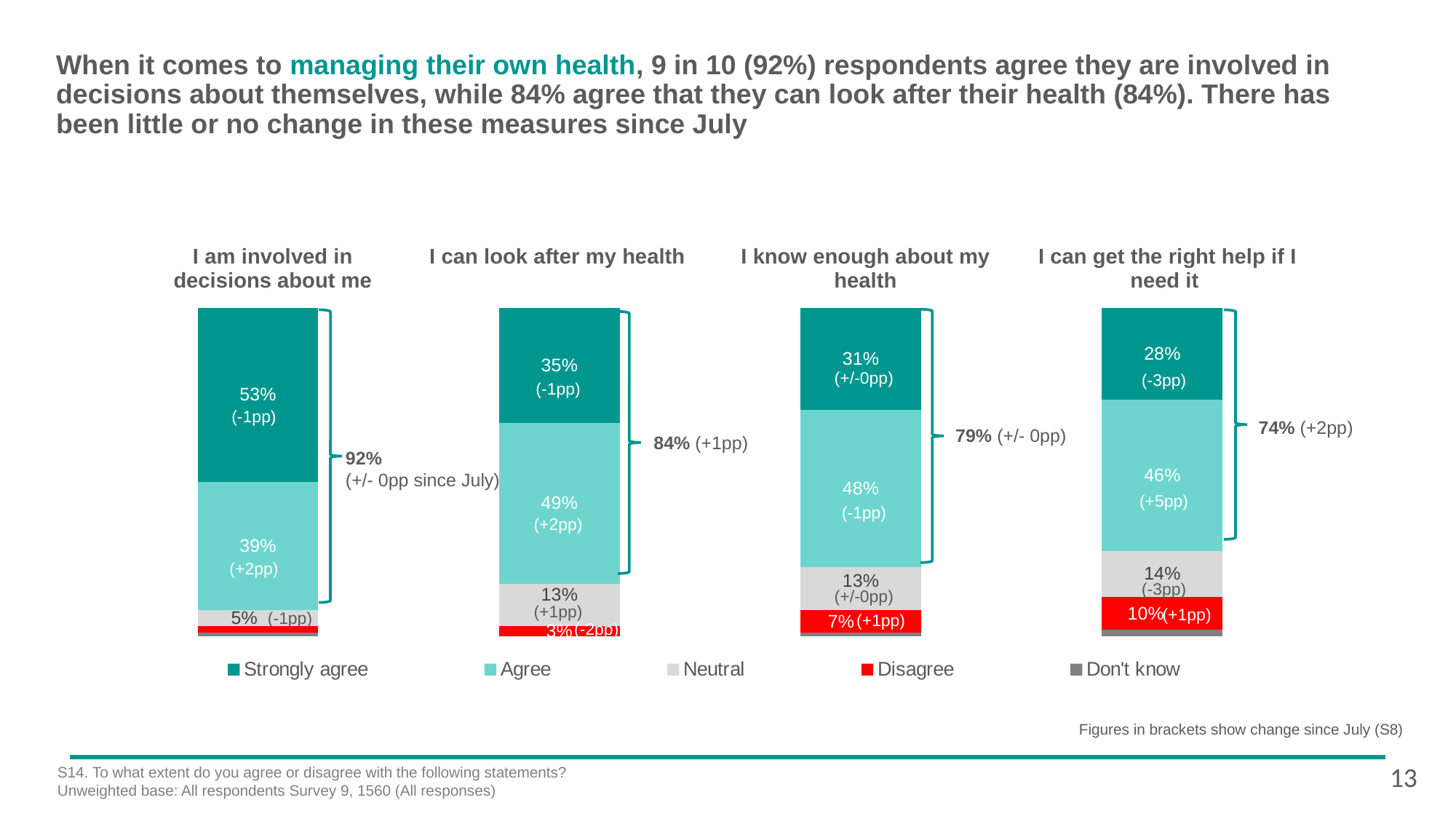
In the chart titled "I can get the right help if I need it", what percentage of respondents are neutral? 14% Across the four charts, which statement has the highest "Strongly agree" percentage? I am involved in decisions about me In the chart titled "I can look after my health", what is the difference between the "Agree" and "Strongly agree" percentages? 14 percentage points In the chart titled "I can look after my health", what percentage of respondents agree? 49% In the chart titled "I am involved in decisions about me", what percentage of respondents strongly agree? 53% How many response categories does the legend list? 5 In the chart titled "I can get the right help if I need it", what change since July is shown for the "Agree" segment? +5pp In the chart titled "I know enough about my health", which is larger: the "Agree" segment or the "Strongly agree" segment? Agree In the chart titled "I can get the right help if I need it", what is the combined total of "Strongly agree" and "Agree" shown by the bracket? 74% What type of chart is used on this slide? Stacked bar chart In the chart titled "I know enough about my health", what percentage of respondents disagree? 7% Across the four charts, which statement has the lowest combined agreement (strongly agree plus agree) shown by the bracket? I can get the right help if I need it